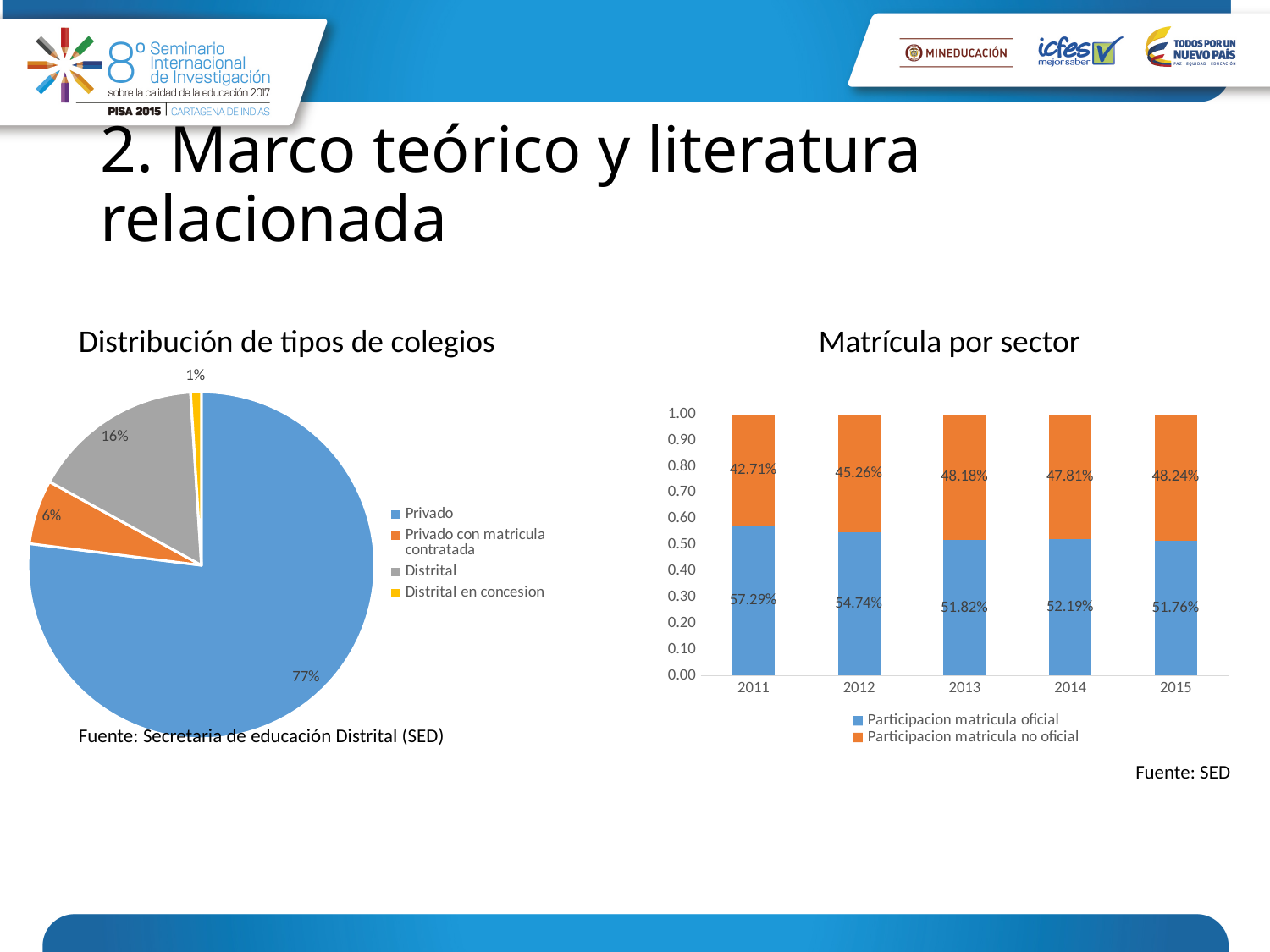
In the 'Distribución de tipos de colegios' chart, what share of the pie is 'Privado'? 77% In the 'Matrícula por sector' chart, does 'Participacion matricula no oficial' generally rise or fall from 2011 to 2015? Rise In the 'Distribución de tipos de colegios' chart, what share of the pie is 'Distrital'? 16% In the 'Matrícula por sector' chart, what is the value of 'Participacion matricula no oficial' for 2015? 48.24% In the 'Matrícula por sector' chart, what is the difference between 'Participacion matricula oficial' in 2011 and in 2012? 2.55% In the 'Matrícula por sector' chart, which year has the highest value for 'Participacion matricula oficial'? 2011 In the 'Matrícula por sector' chart, what is the value of 'Participacion matricula oficial' for 2011? 57.29% In the 'Distribución de tipos de colegios' chart, which category has the smallest slice? Distrital en concesion In the 'Matrícula por sector' chart, how many series does the legend list? 2 What kind of chart is 'Distribución de tipos de colegios'? Pie chart In the 'Distribución de tipos de colegios' chart, how many categories does the legend list? 4 In the 'Matrícula por sector' chart, is 'Participacion matricula no oficial' larger in 2013 or in 2011? 2013